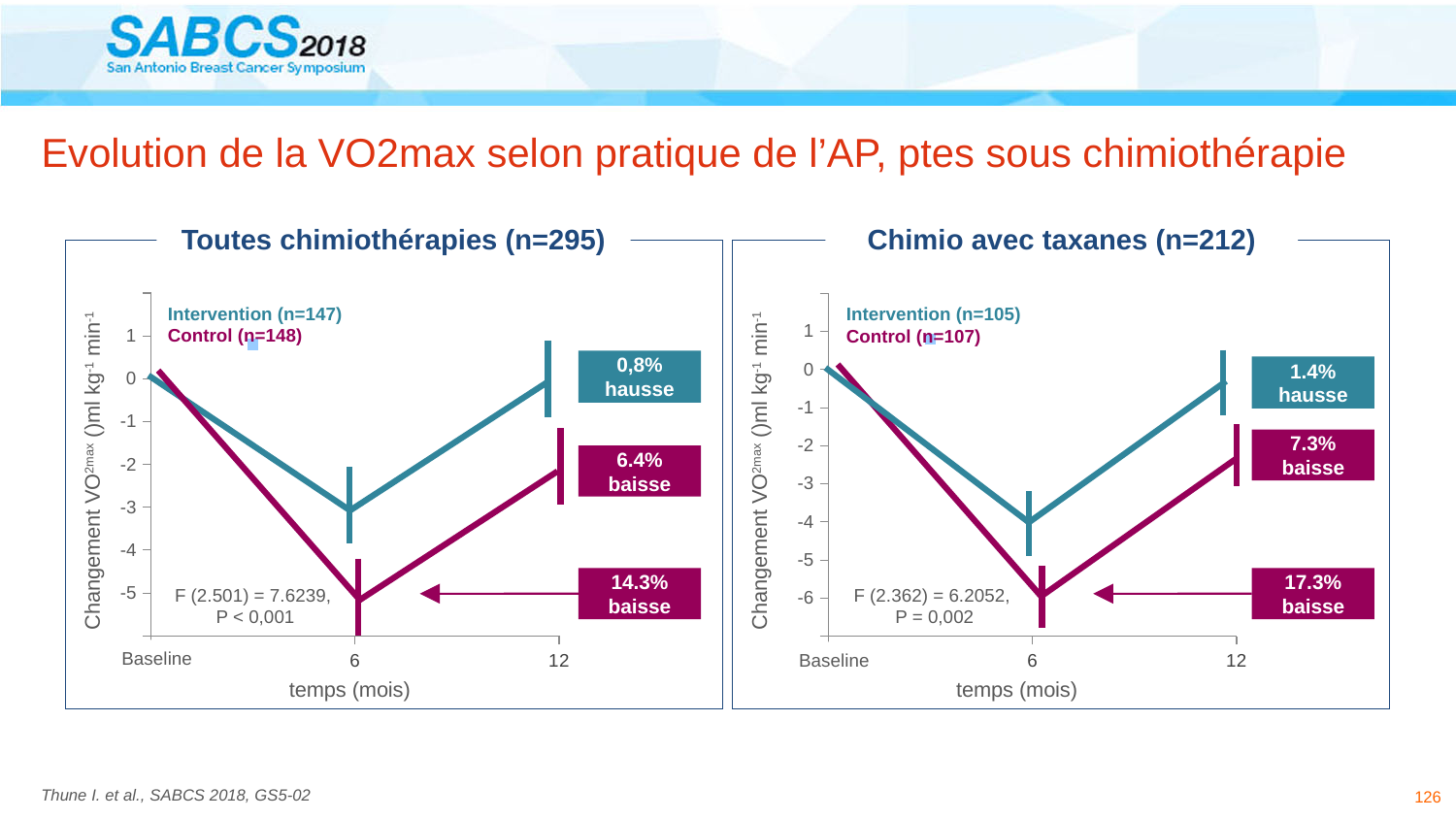
In the left chart 'Toutes chimiothérapies (n=295)', is the Control value at 6 months greater or less than -4? less In the right chart 'Chimio avec taxanes (n=212)', what percentage change is labelled for the Control group at 12 months? 7.3% baisse In the right chart 'Chimio avec taxanes (n=212)', how many time points are shown on the x axis? 3 In the left chart 'Toutes chimiothérapies (n=295)', how many series are listed in the legend? 2 In the left chart 'Toutes chimiothérapies (n=295)', what percentage change is labelled for the Control group at 6 months? 14.3% baisse In the right chart 'Chimio avec taxanes (n=212)', what is the sample size of the Control group shown in the legend? n=107 In the right chart 'Chimio avec taxanes (n=212)', at 6 months, which group has the higher value, Intervention or Control? Intervention In the right chart 'Chimio avec taxanes (n=212)', is the Intervention value at 6 months greater or less than -5? greater In the right chart 'Chimio avec taxanes (n=212)', what percentage change is labelled for the Intervention group at 12 months? 1.4% hausse What kind of chart is the left chart, 'Toutes chimiothérapies (n=295)'? line chart In the left chart 'Toutes chimiothérapies (n=295)', do the Control values rise or fall between 6 and 12 months? rise In the left chart 'Toutes chimiothérapies (n=295)', what percentage change is labelled for the Intervention group at 12 months? 0,8% hausse